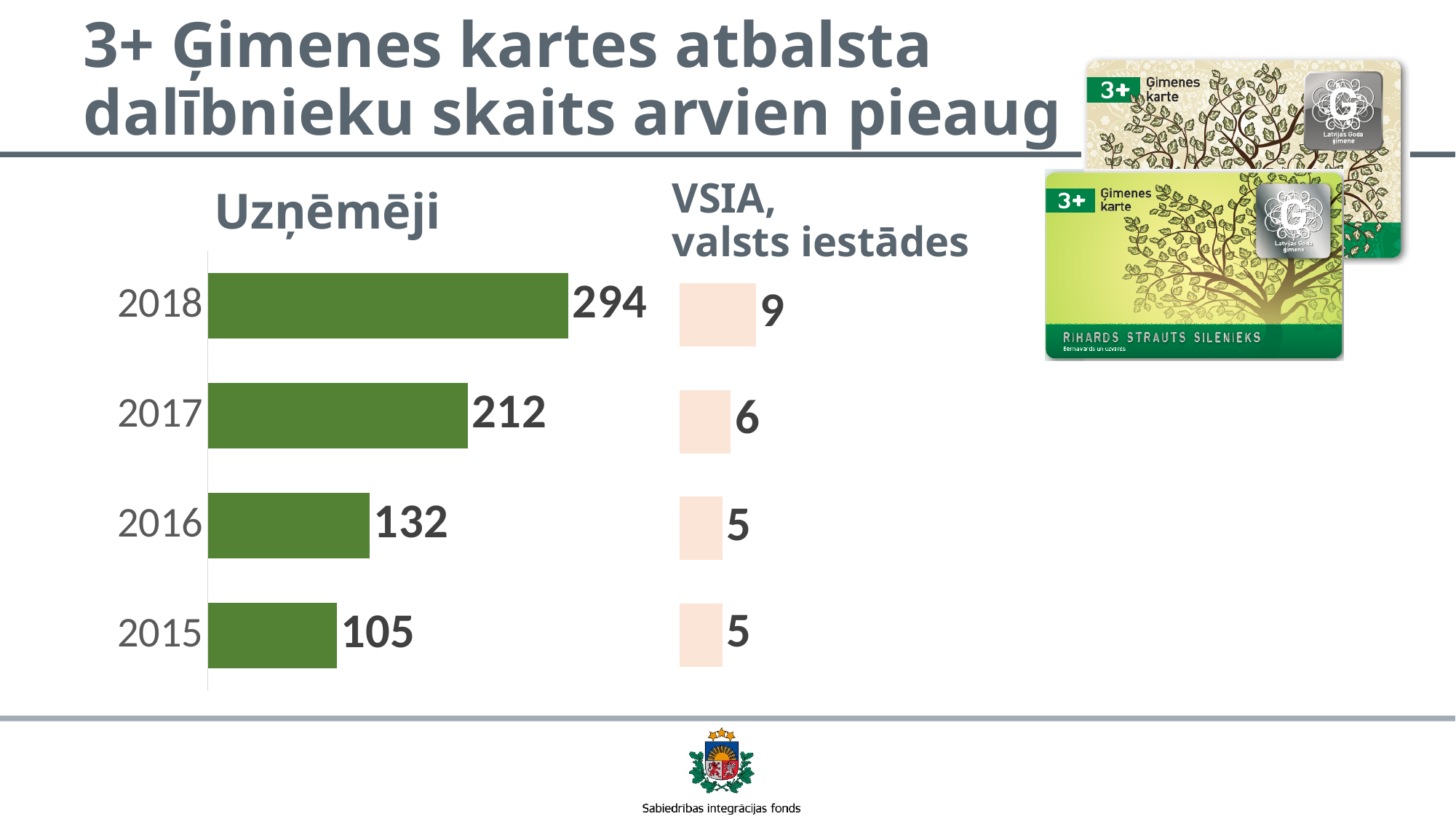
What kind of chart is shown on the slide? Bar chart What is the VSIA, valsts iestādes value for 2017? 6 What is the difference between the VSIA, valsts iestādes values for 2018 and 2016? 4 What is the difference between the Uzņēmēji values for 2018 and 2017? 82 What is the VSIA, valsts iestādes value for 2015? 5 What is the Uzņēmēji value for 2018? 294 Which year has the lowest Uzņēmēji value? 2015 How many years are shown in the chart? 4 Do the Uzņēmēji values rise or fall from 2015 to 2018? Rise Which year has the highest Uzņēmēji value? 2018 Which is larger, the Uzņēmēji value for 2017 or for 2016? 2017 What is the Uzņēmēji value for 2016? 132